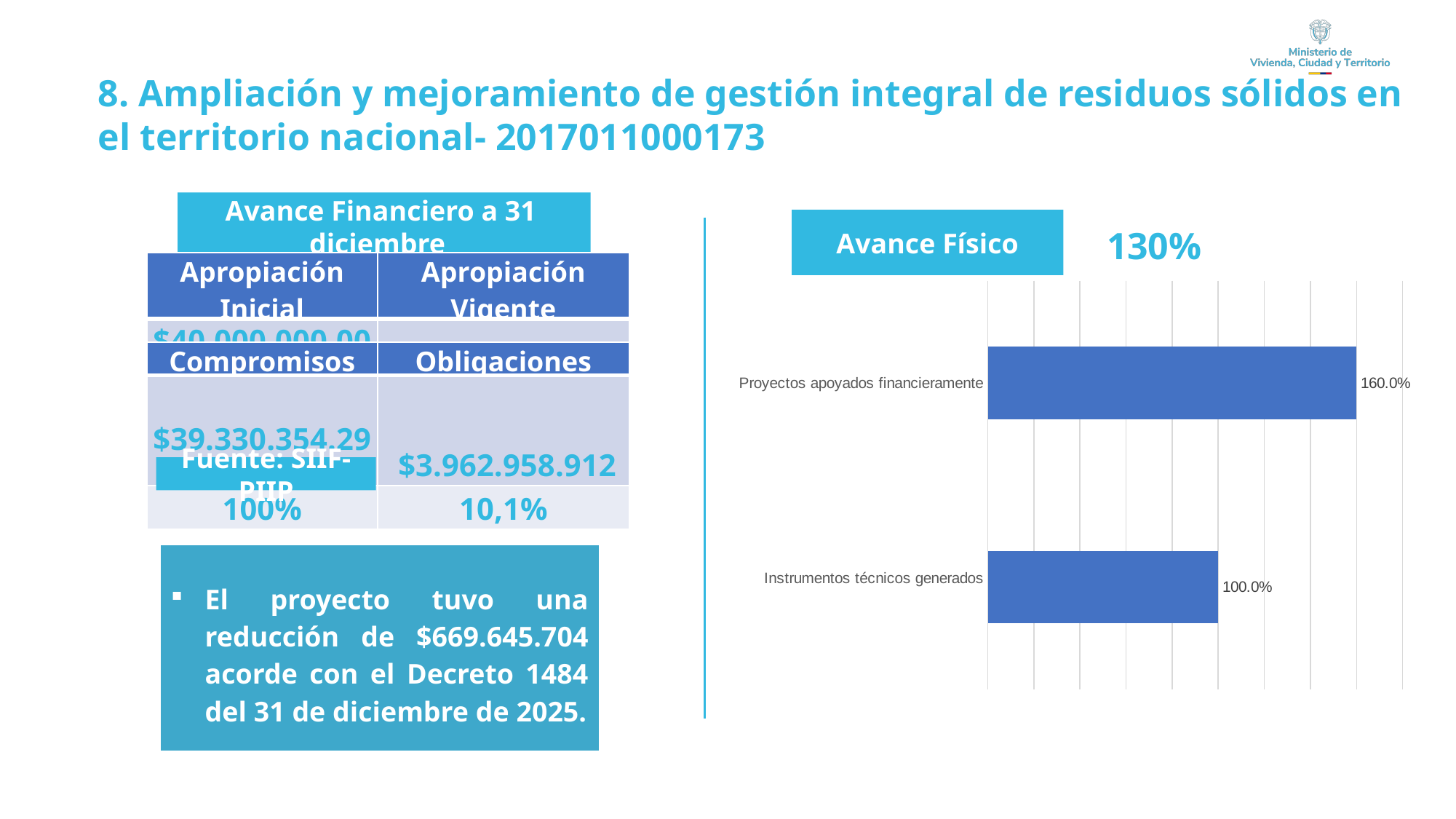
What is the value for Instrumentos técnicos generados in the Avance Físico chart? 100.0% How many categories are shown in the Avance Físico chart? 2 What overall percentage is displayed next to the Avance Físico chart title? 130% What is the title of the chart on the right side of the slide? Avance Físico Which category has the highest value in the Avance Físico chart? Proyectos apoyados financieramente What is the value for Proyectos apoyados financieramente in the Avance Físico chart? 160.0% Which category has the lowest value in the Avance Físico chart? Instrumentos técnicos generados In the Avance Físico chart, which is larger: Proyectos apoyados financieramente or Instrumentos técnicos generados? Proyectos apoyados financieramente What kind of chart is the Avance Físico chart? Bar chart What is the difference between the values for Proyectos apoyados financieramente and Instrumentos técnicos generados in the Avance Físico chart? 60.0%